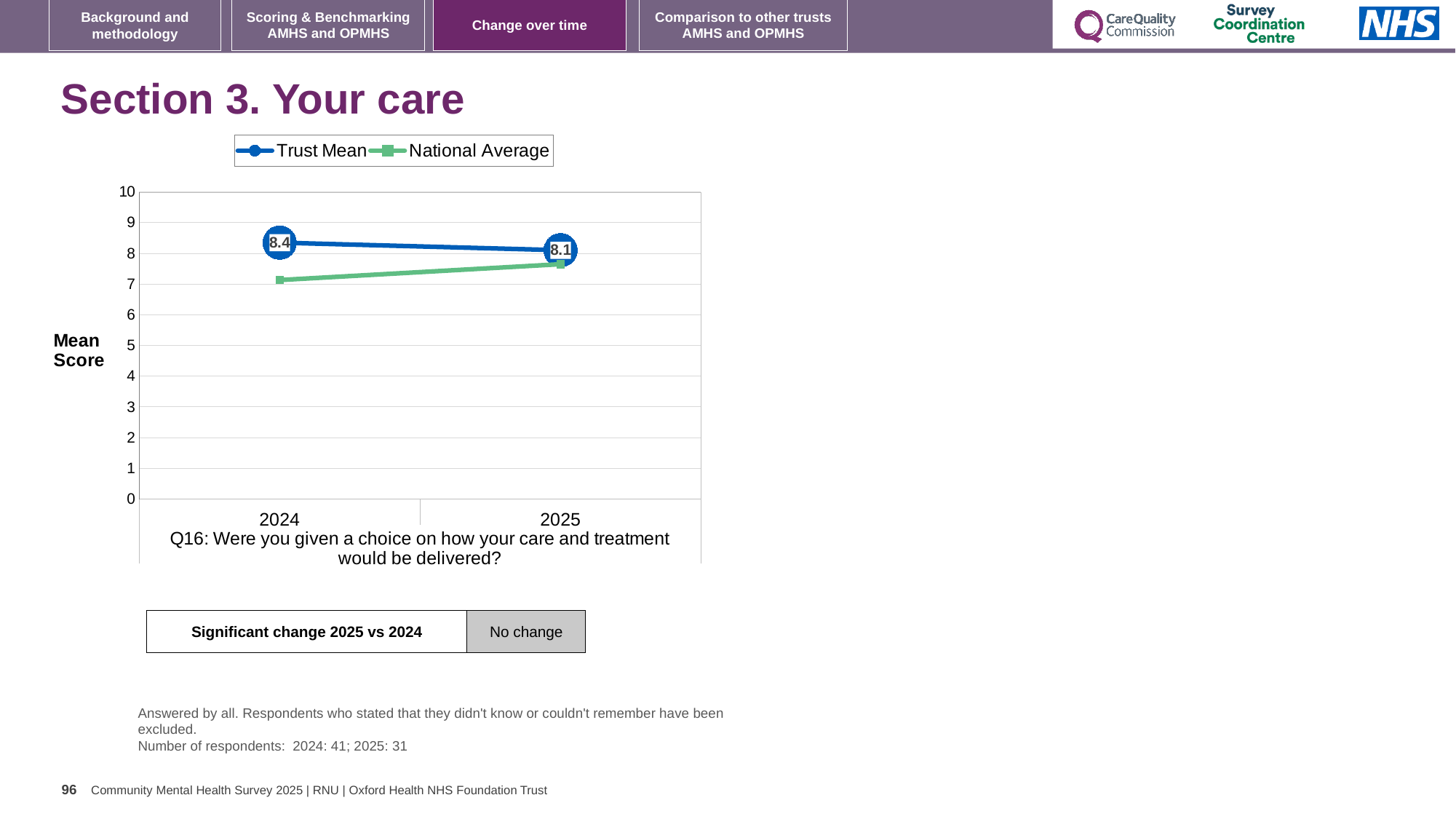
Does the Trust Mean rise or fall from 2024 to 2025? fall What is the Trust Mean score for 2024? 8.4 How many series does the legend list? 2 Does the National Average rise or fall from 2024 to 2025? rise In 2024, which is higher, the Trust Mean or the National Average? Trust Mean What is the Trust Mean score for 2025? 8.1 Is the National Average for 2024 greater or less than 8? less What kind of chart is shown on the slide? line chart By how much did the Trust Mean change from 2024 to 2025? -0.3 Which year has the higher Trust Mean score, 2024 or 2025? 2024 Is the National Average for 2025 greater or less than 7? greater How many years are plotted on the x axis? 2